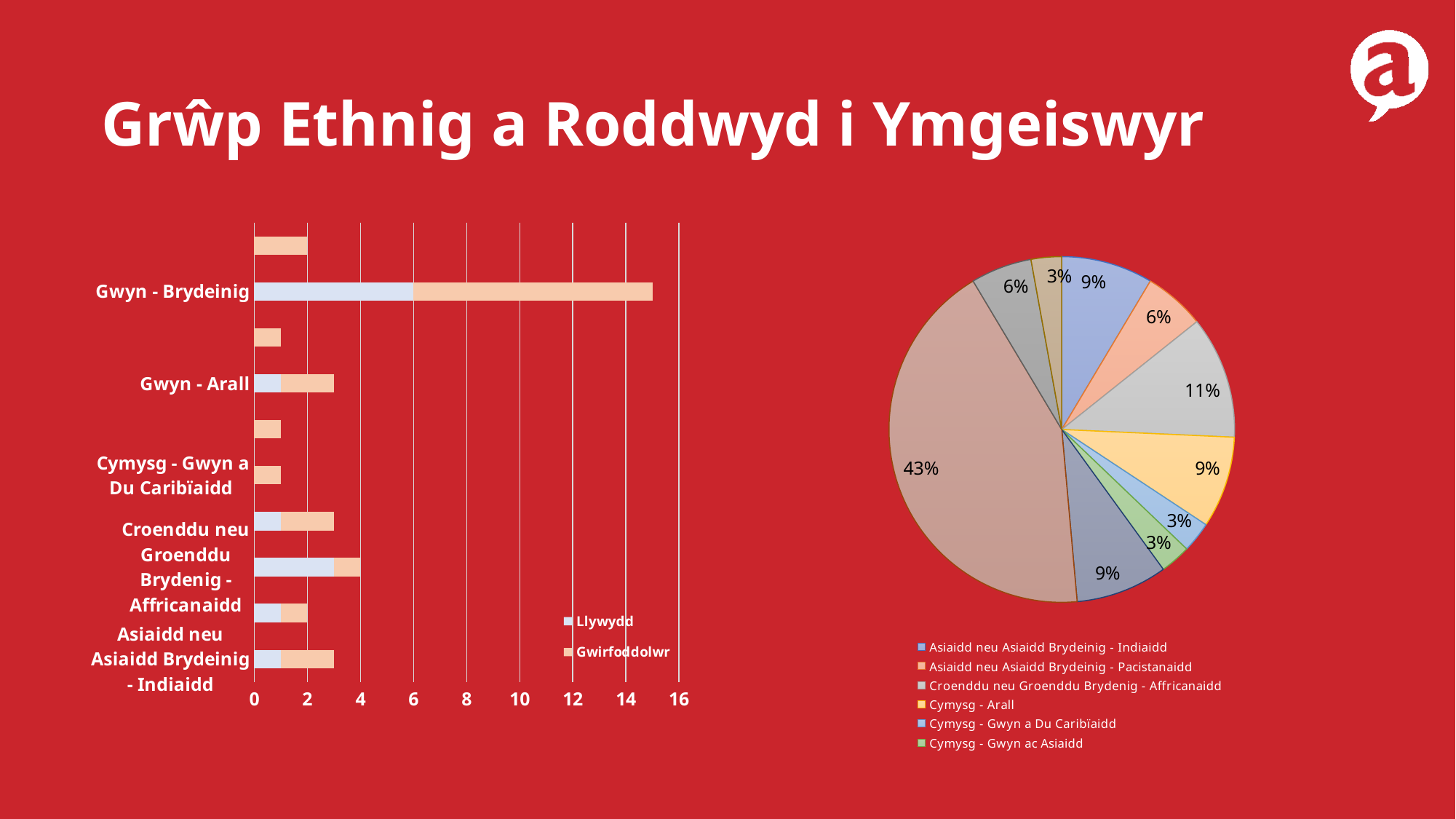
On the pie chart, what is the share of the largest slice? 43% On the pie chart, what share is shown for Asiaidd neu Asiaidd Brydeinig - Pacistanaidd? 6% How many series does the legend of the bar chart on the left list? 2 On the pie chart, what is the difference in percentage points between the Croenddu neu Groenddu Brydenig - Affricanaidd slice and the Asiaidd neu Asiaidd Brydeinig - Pacistanaidd slice? 5 percentage points What kind of chart is the chart on the left of the slide? Bar chart On the pie chart, which is larger: the slice for Asiaidd neu Asiaidd Brydeinig - Indiaidd or the slice for Asiaidd neu Asiaidd Brydeinig - Pacistanaidd? Asiaidd neu Asiaidd Brydeinig - Indiaidd On the bar chart on the left, what is the Llywydd value for Gwyn - Brydeinig? 6 On the bar chart on the left, is the total value for Gwyn - Brydeinig greater or less than 14? greater On the pie chart, what share is shown for Cymysg - Arall? 9% On the pie chart, what share is shown for Croenddu neu Groenddu Brydenig - Affricanaidd? 11% How many entries does the legend of the pie chart list? 6 How many slices does the pie chart have? 10